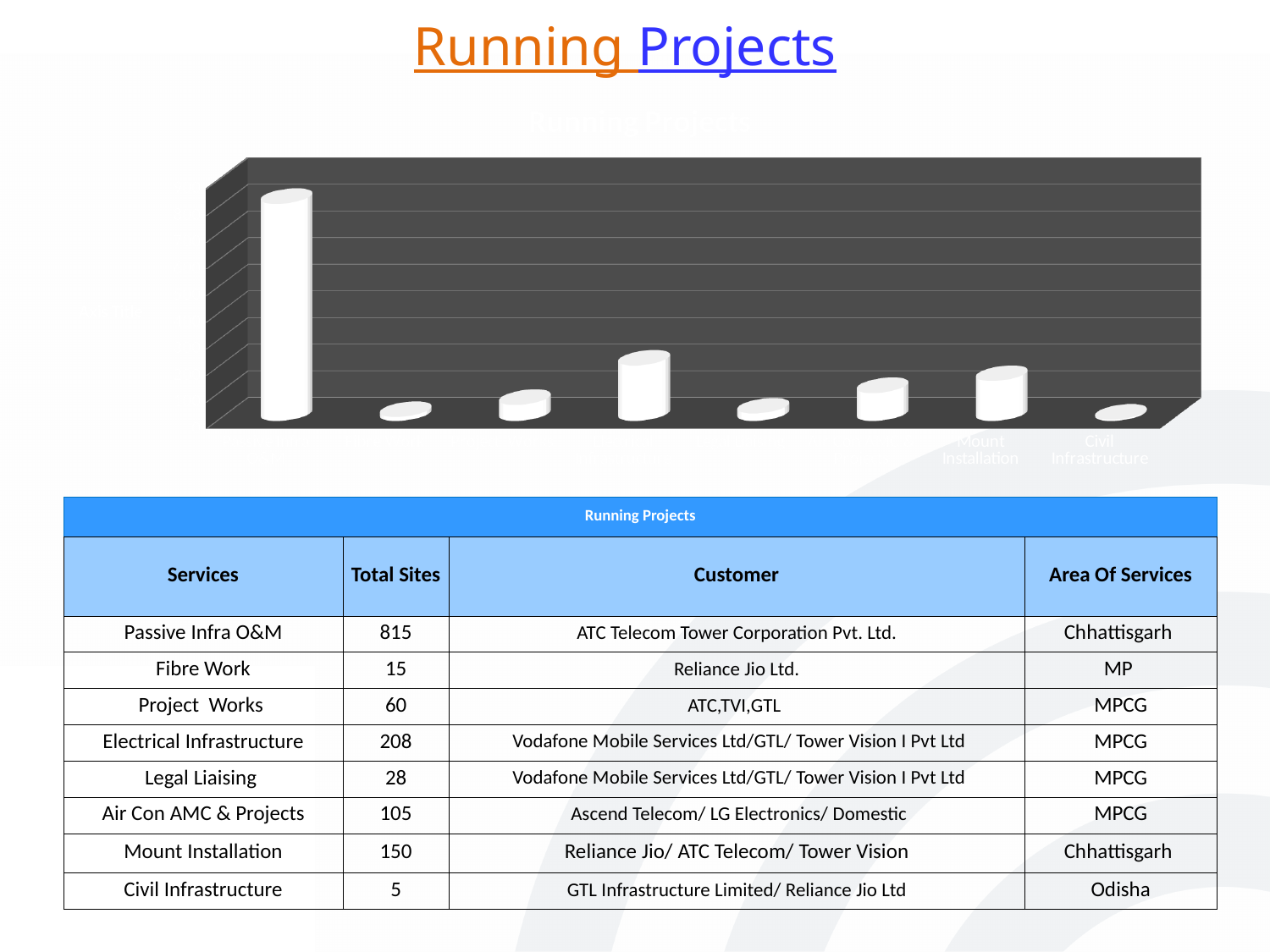
What kind of chart is shown on the slide? bar chart How many bars does the chart show? 8 Which is taller in the chart, the first bar or the fourth bar? the first bar Which is taller in the chart, the fourth bar or the sixth bar? the fourth bar What is the title of the slide? Running Projects Which bar in the chart is the tallest? the first (leftmost) bar Which is taller in the chart, the bar for Mount Installation or the bar for Civil Infrastructure? Mount Installation Do the bar heights in the chart rise or fall from the first bar to the second bar? fall What colour are the bars in the chart? white